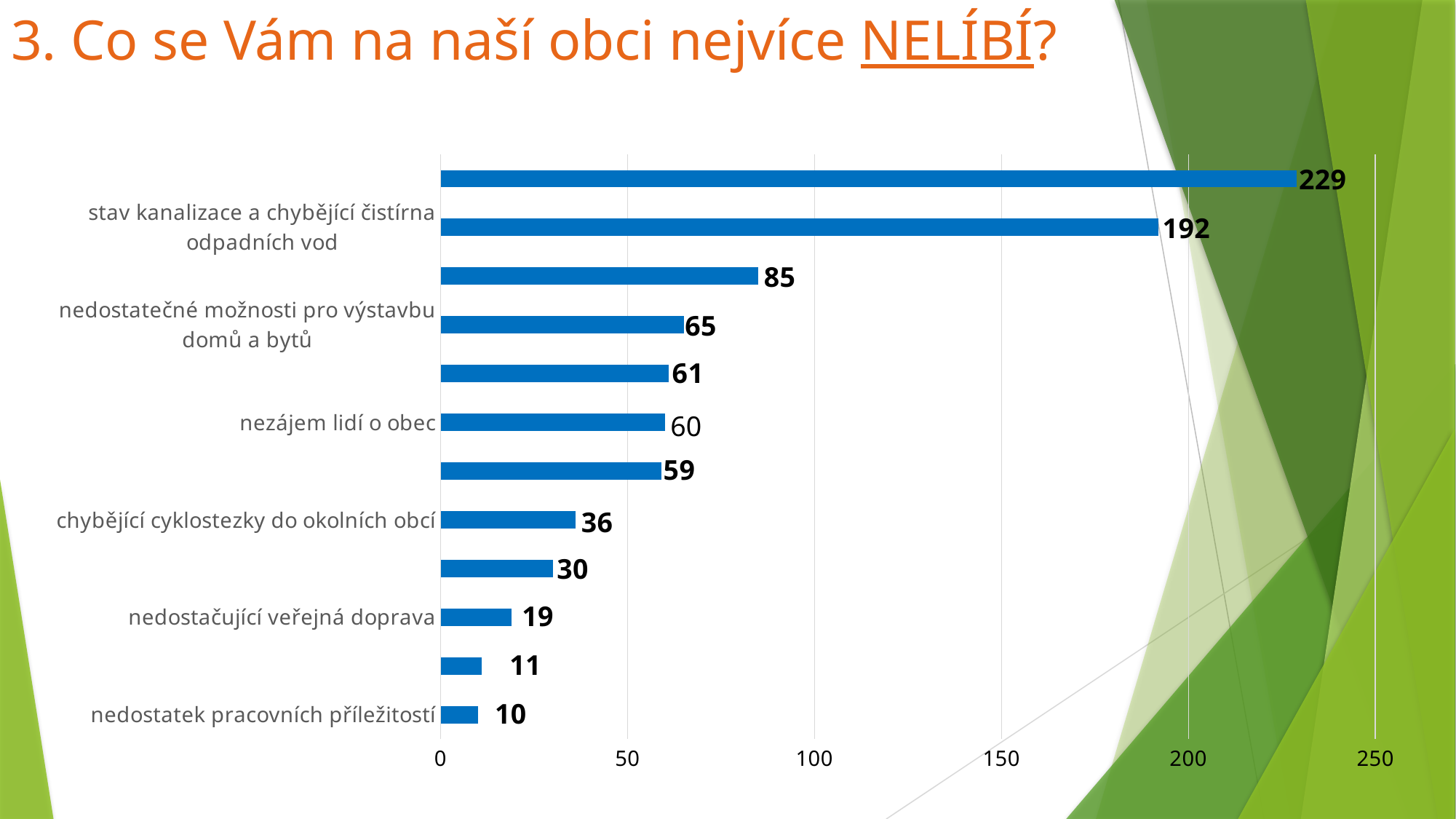
What is the value for "chybějící cyklostezky do okolních obcí"? 36 What is the highest value shown in the chart? 229 Which category has the lowest value? nedostatek pracovních příležitostí What is the difference between the values for "stav kanalizace a chybějící čistírna odpadních vod" and "nedostatečné možnosti pro výstavbu domů a bytů"? 127 What is the value for "stav kanalizace a chybějící čistírna odpadních vod"? 192 What type of chart is shown on the slide? bar chart What is the value for "nezájem lidí o obec"? 60 Which is larger: the value for "nezájem lidí o obec" or for "chybějící cyklostezky do okolních obcí"? nezájem lidí o obec What is the value for "nedostačující veřejná doprava"? 19 What is the title of the slide? 3. Co se Vám na naší obci nejvíce NELÍBÍ? What is the value for "nedostatečné možnosti pro výstavbu domů a bytů"? 65 How many bars are plotted in the chart? 12